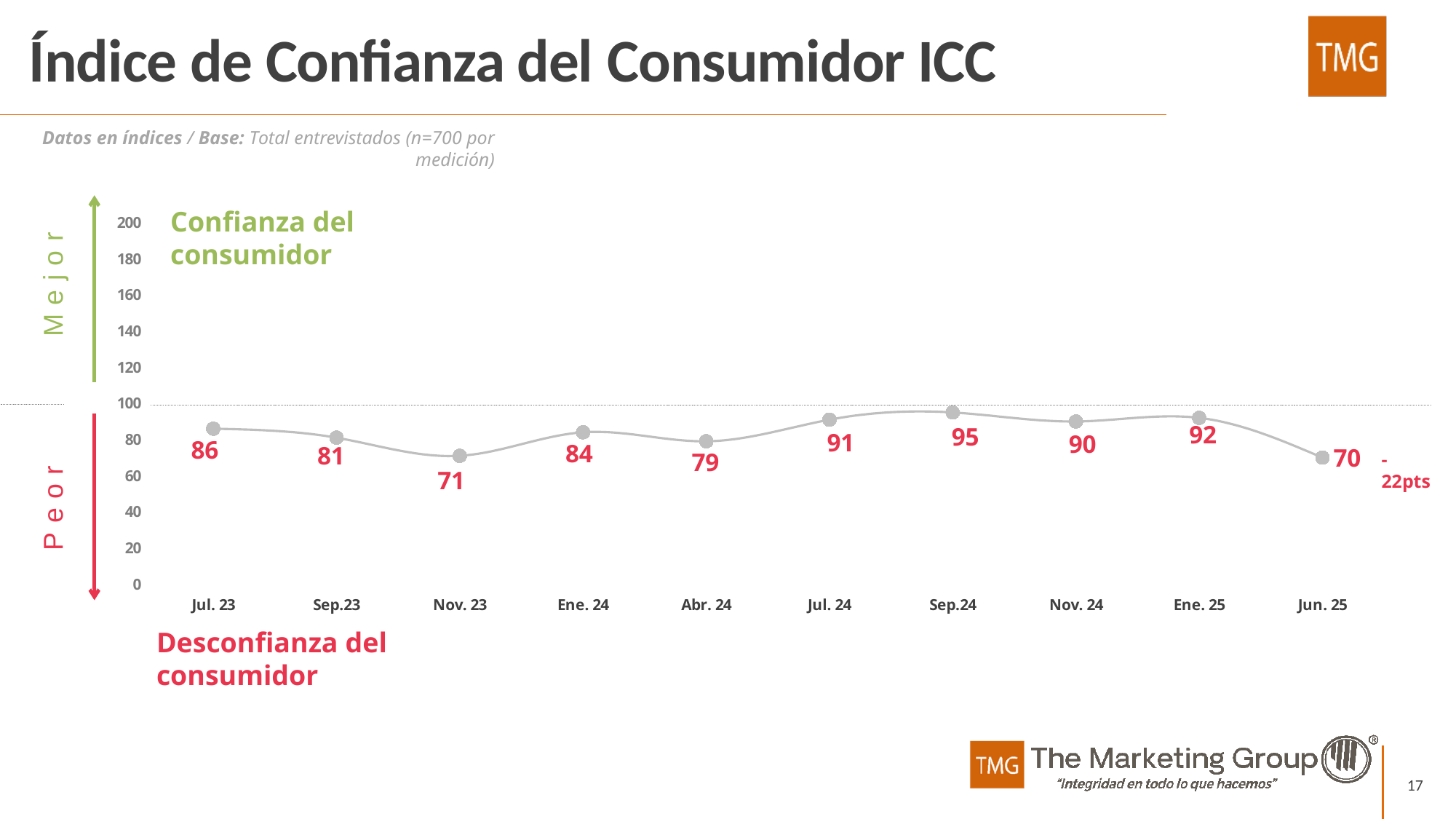
What is the difference between the index values for Ene. 25 and Jun. 25? 22 Which period has the lowest index value? Jun. 25 What kind of chart is shown on the slide? line chart Does the index rise or fall between Ene. 25 and Jun. 25? fall What is the value of the index for Jun. 25? 70 What is the base (sample size) stated for each measurement? n=700 por medición What is the value of the Índice de Confianza del Consumidor for Nov. 23? 71 How many time periods are plotted on the chart? 10 Which is larger, the index value for Jul. 23 or for Sep.23? Jul. 23 Which period has the highest index value? Sep.24 Is the value for Abr. 24 greater or less than 100? less What is the value of the index for Sep.24? 95